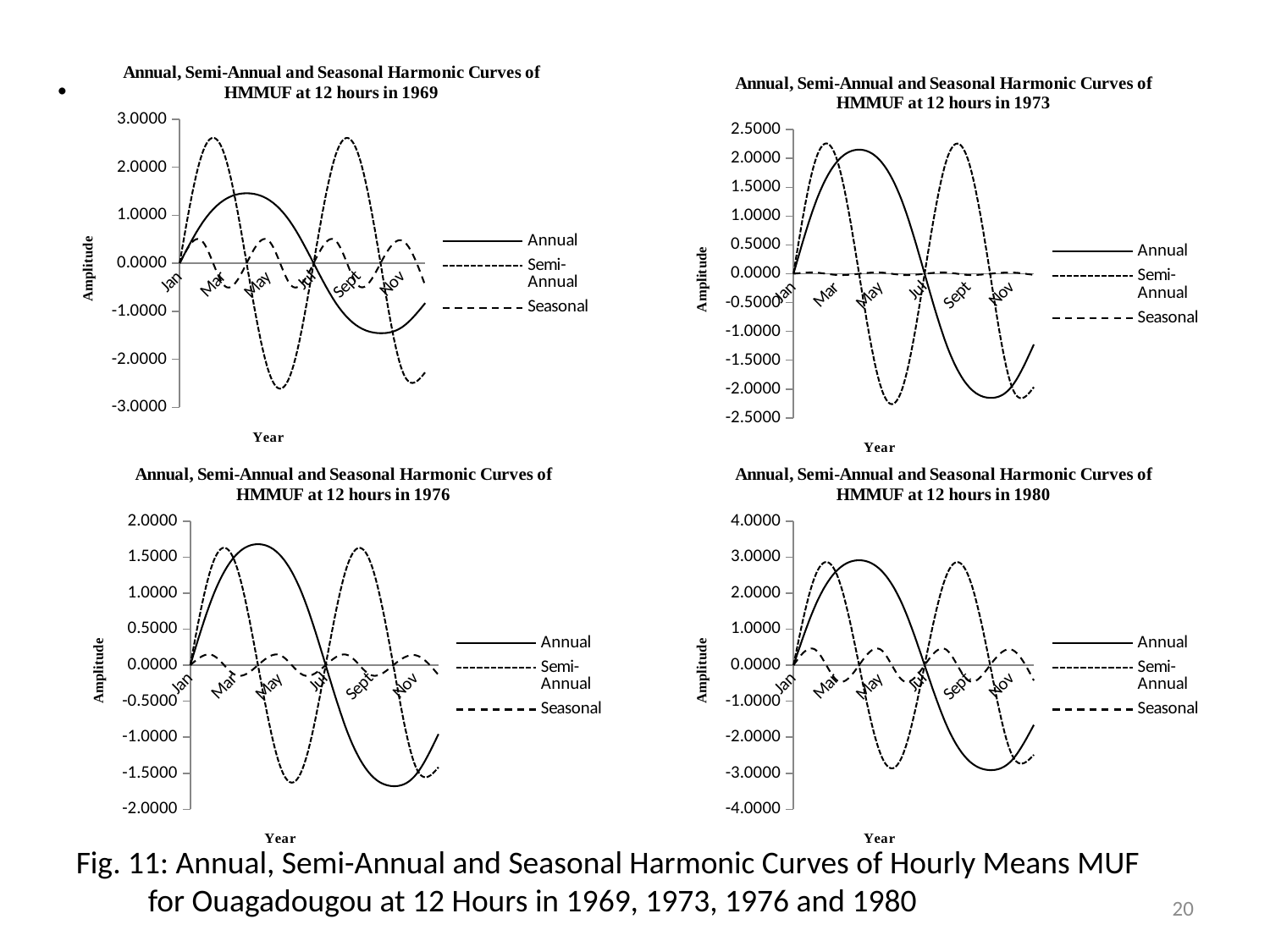
In the 1980 chart, what are the legend entries? Annual, Semi-Annual, Seasonal How many charts are shown on the slide? 4 In the 1973 chart, which series has the smallest amplitude? Seasonal In the 1976 chart, what is the label on the x axis? Year In the 1969 chart, is the peak value of the Semi-Annual curve greater or less than 2.0000? greater In the 1973 chart, how many series does the legend list? 3 In the 1973 chart, does the Annual curve rise or fall between Jul and Sept? fall In the 1980 chart, is the maximum value of the Annual curve greater or less than 2.0000? greater In the 1969 chart, is the peak value of the Annual curve greater or less than 2.0000? less What kind of chart is the 'Annual, Semi-Annual and Seasonal Harmonic Curves of HMMUF at 12 hours in 1969' chart? line chart In the 1969 chart, which curve reaches a higher peak, Annual or Semi-Annual? Semi-Annual